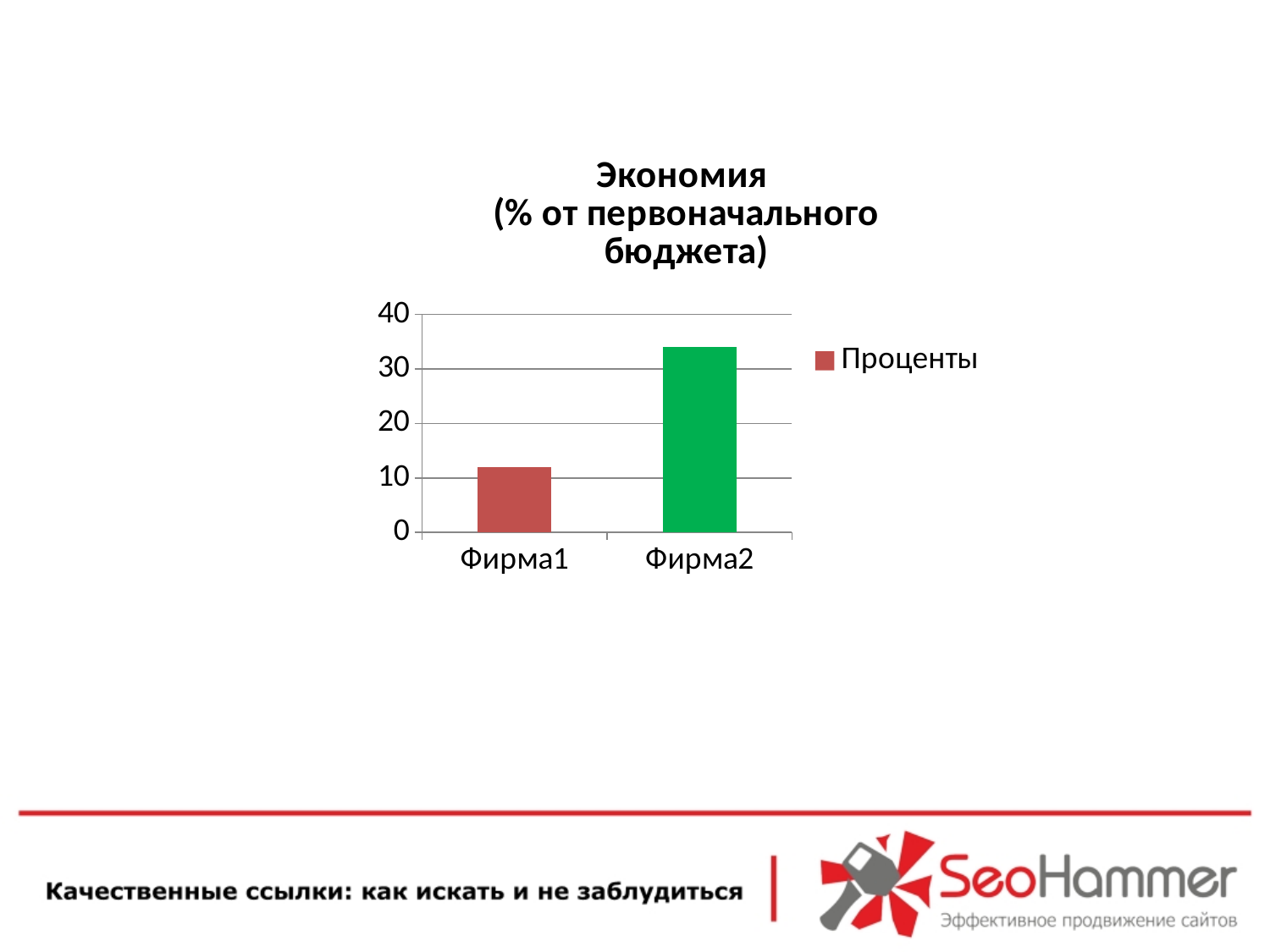
How many series does the chart's legend list? 1 Is the value for Фирма1 greater or less than 10? greater Is the value for Фирма2 greater or less than 40? less How many categories are shown on the x axis of the chart? 2 What is the title of the chart? Экономия (% от первоначального бюджета) Is the value for Фирма2 greater or less than 30? greater Which category has the highest value in the chart? Фирма2 What kind of chart is shown on the slide? bar chart What series name is shown in the chart's legend? Проценты Which category has the lowest value in the chart? Фирма1 Which is larger, the value for Фирма1 or the value for Фирма2? Фирма2